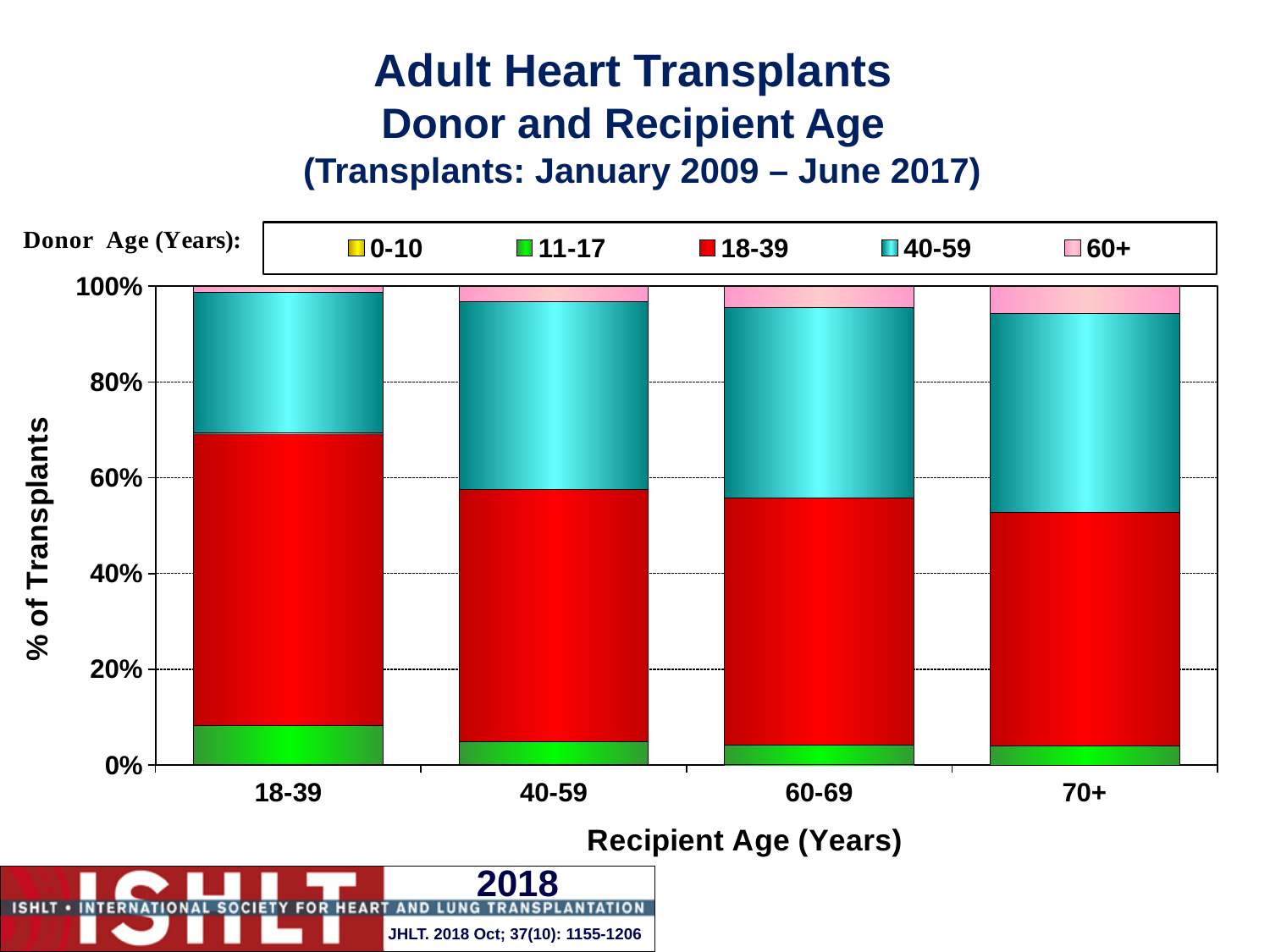
How many donor age groups does the legend list? 5 Is the share of donors aged 11-17 for recipients aged 18-39 greater or less than 20%? less What is the label of the x axis? Recipient Age (Years) What kind of chart is shown on the slide? Stacked bar chart Is the share of donors aged 18-39 for recipients aged 70+ greater or less than 60%? less Does the share of donors aged 18-39 rise or fall as recipient age increases from 18-39 to 70+? fall What is the label of the y axis? % of Transplants How many recipient age groups are shown on the x axis? 4 Is the share of donors aged 18-39 larger for recipients aged 18-39 or for recipients aged 70+? 18-39 Which recipient age group has the largest share of donors aged 60+? 70+ Which recipient age group has the largest share of donors aged 18-39? 18-39 Which recipient age group has the largest share of donors aged 11-17? 18-39